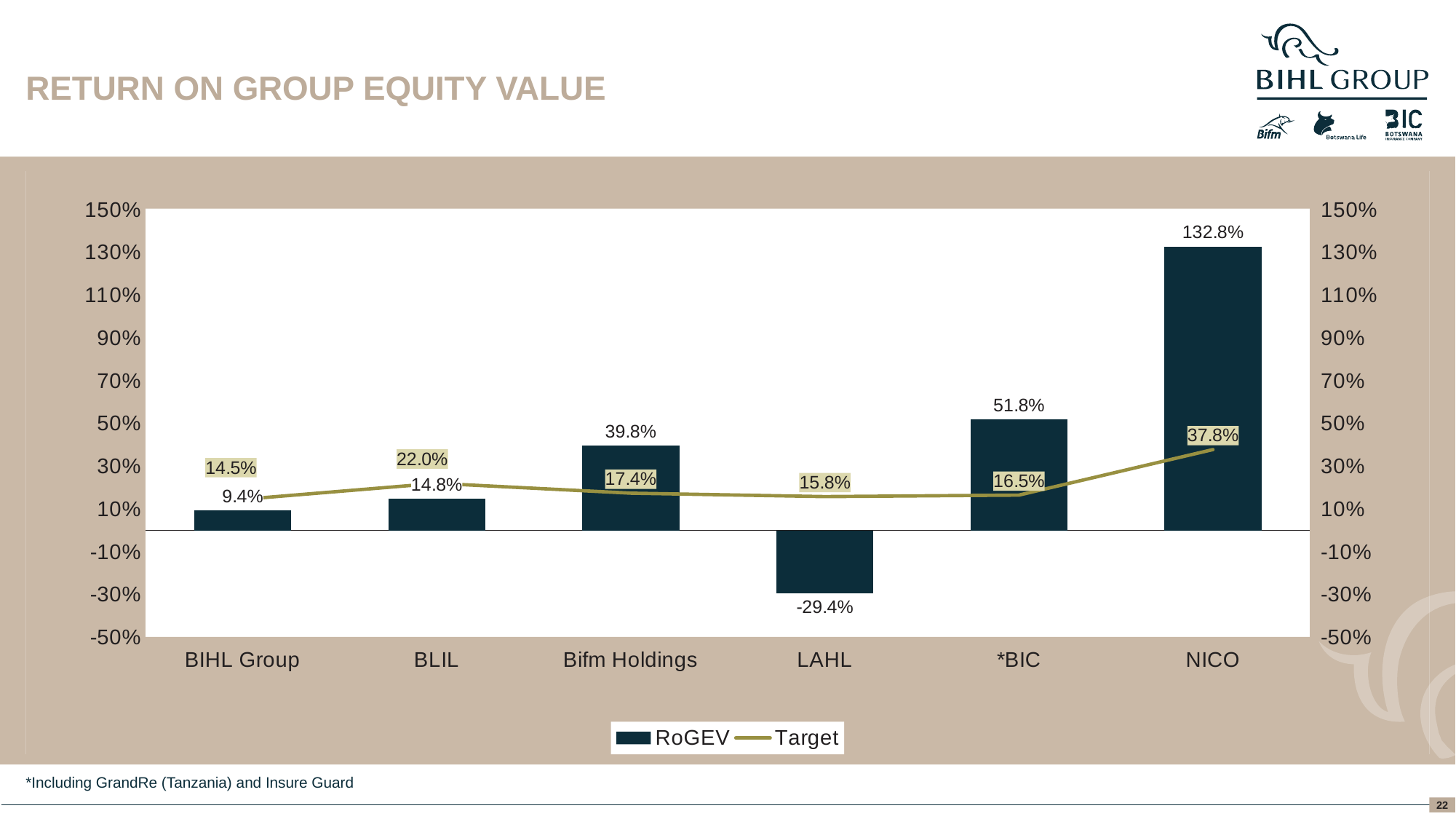
Which is larger for BIHL Group, the RoGEV value or the Target value? Target Which category has the highest RoGEV value? NICO What is the RoGEV value for LAHL? -29.4% What is the RoGEV value for NICO? 132.8% What is the title of the slide? RETURN ON GROUP EQUITY VALUE How many series does the legend list? 2 What is the Target value for BLIL? 22.0% Which category has the lowest RoGEV value? LAHL How many categories are shown on the x axis? 6 What is the Target value for *BIC? 16.5% What kind of chart is used to show the RoGEV series? Bar chart What is the difference between the RoGEV value and the Target value for Bifm Holdings? 22.4%